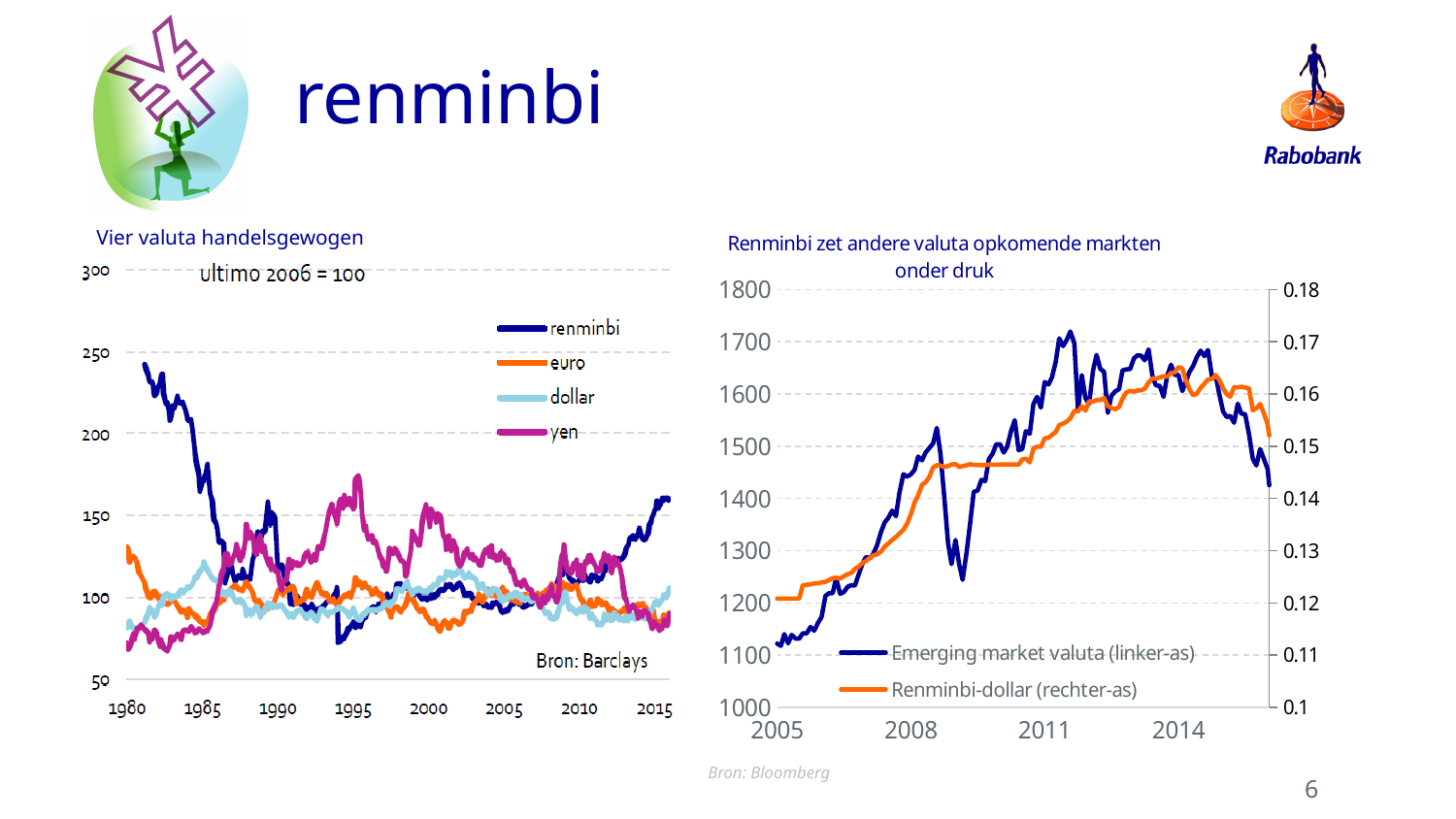
How many series does the legend of the 'Vier valuta handelsgewogen' chart list? 4 In the 'Renminbi zet andere valuta opkomende markten onder druk' chart, does the Renminbi-dollar line rise or fall between 2005 and 2014? rise What base period is stated in the 'Vier valuta handelsgewogen' chart? ultimo 2006 = 100 In the 'Vier valuta handelsgewogen' chart, is the peak value for yen around 1995 greater or less than 150? greater In the 'Vier valuta handelsgewogen' chart, does the renminbi line rise or fall between 2005 and 2015? rise In the 'Renminbi zet andere valuta opkomende markten onder druk' chart, is the value for Renminbi-dollar in 2005 greater or less than 0.13? less In the 'Renminbi zet andere valuta opkomende markten onder druk' chart, is the value for Emerging market valuta in 2005 greater or less than 1200? less In the 'Vier valuta handelsgewogen' chart, does the renminbi line rise or fall between 1980 and 1994? fall What is the source given for the 'Vier valuta handelsgewogen' chart? Barclays How many series does the legend of the 'Renminbi zet andere valuta opkomende markten onder druk' chart list? 2 What kind of chart is the 'Vier valuta handelsgewogen' chart on the left? line chart